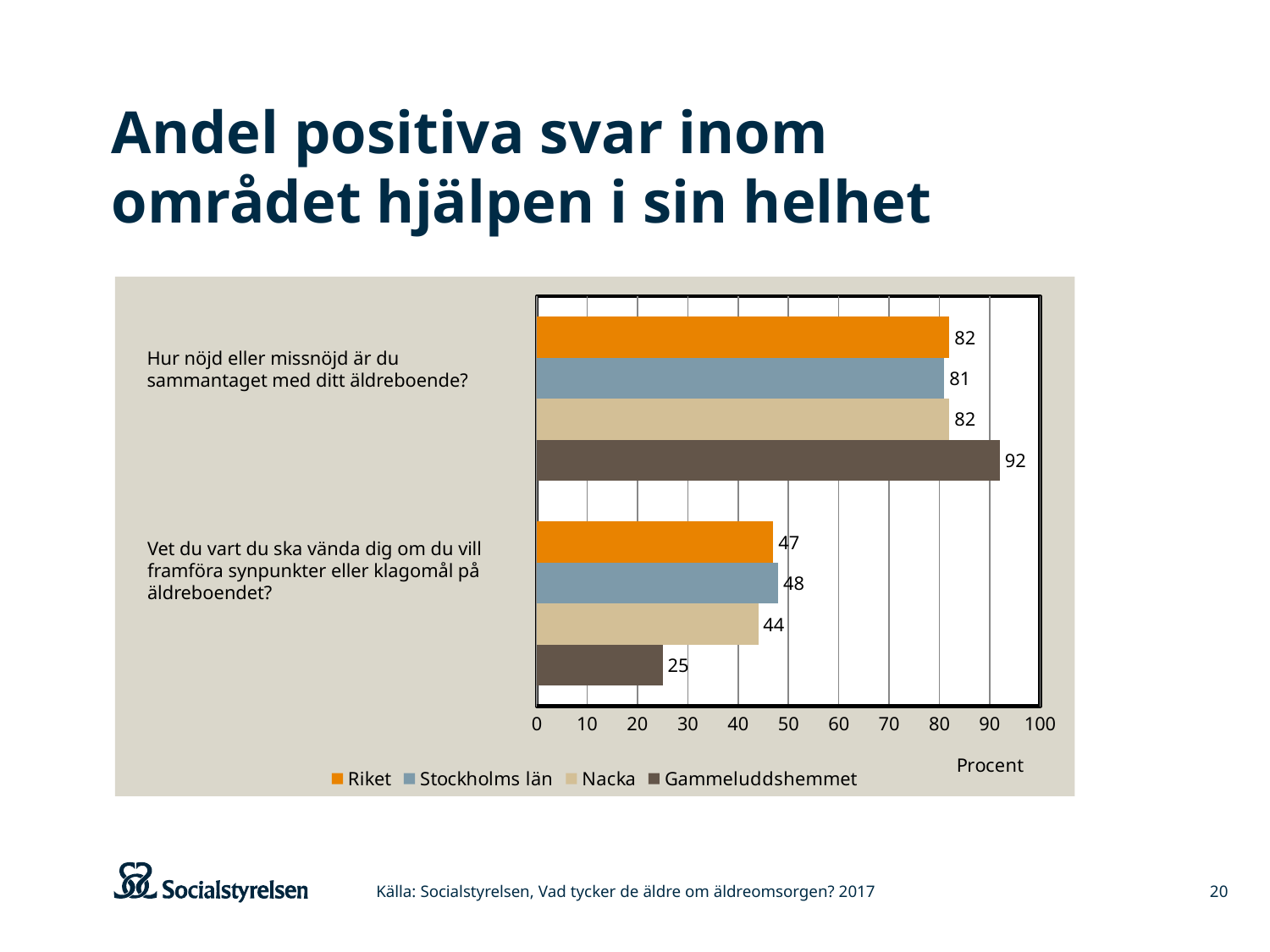
Which series has the lowest value for the question "Vet du vart du ska vända dig om du vill framföra synpunkter eller klagomål på äldreboendet?"? Gammeluddshemmet What is the value for Stockholms län for the question "Hur nöjd eller missnöjd är du sammantaget med ditt äldreboende?"? 81 Which is larger for the question "Vet du vart du ska vända dig om du vill framföra synpunkter eller klagomål på äldreboendet?": Riket or Gammeluddshemmet? Riket How many series does the legend list? 4 What is the difference between the Gammeluddshemmet values for the two questions? 67 What kind of chart is shown on the slide? Bar chart What is the value for Gammeluddshemmet for the question "Hur nöjd eller missnöjd är du sammantaget med ditt äldreboende?"? 92 What is the difference between Stockholms län and Nacka for the question "Vet du vart du ska vända dig om du vill framföra synpunkter eller klagomål på äldreboendet?"? 4 What is the value for Nacka for the question "Vet du vart du ska vända dig om du vill framföra synpunkter eller klagomål på äldreboendet?"? 44 Which series has the highest value for the question "Hur nöjd eller missnöjd är du sammantaget med ditt äldreboende?"? Gammeluddshemmet What unit is shown on the horizontal axis of the chart? Procent What is the value for Riket for the question "Vet du vart du ska vända dig om du vill framföra synpunkter eller klagomål på äldreboendet?"? 47